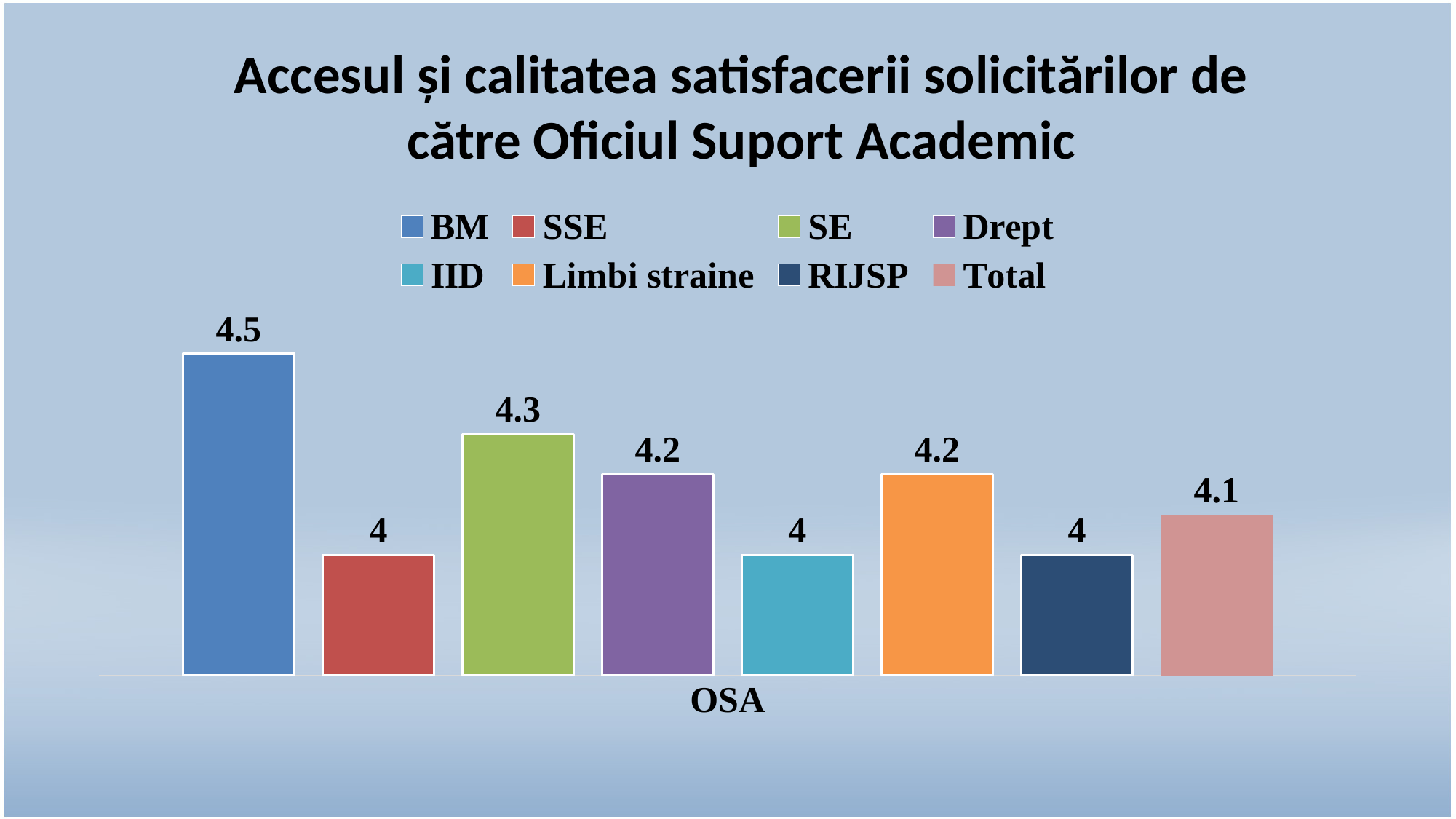
What is the difference between the values for SE and Total? 0.2 What is the value for RIJSP? 4 Which is larger, the value for Drept or the value for IID? Drept Which series has the highest value? BM What is the value for SE? 4.3 What is the difference between the values for BM and SSE? 0.5 How many series does the legend list? 8 What kind of chart is shown on the slide? Bar chart What is the value for Limbi straine? 4.2 What is the value for BM? 4.5 What is the value for Total? 4.1 What is the label on the x axis under the bars? OSA